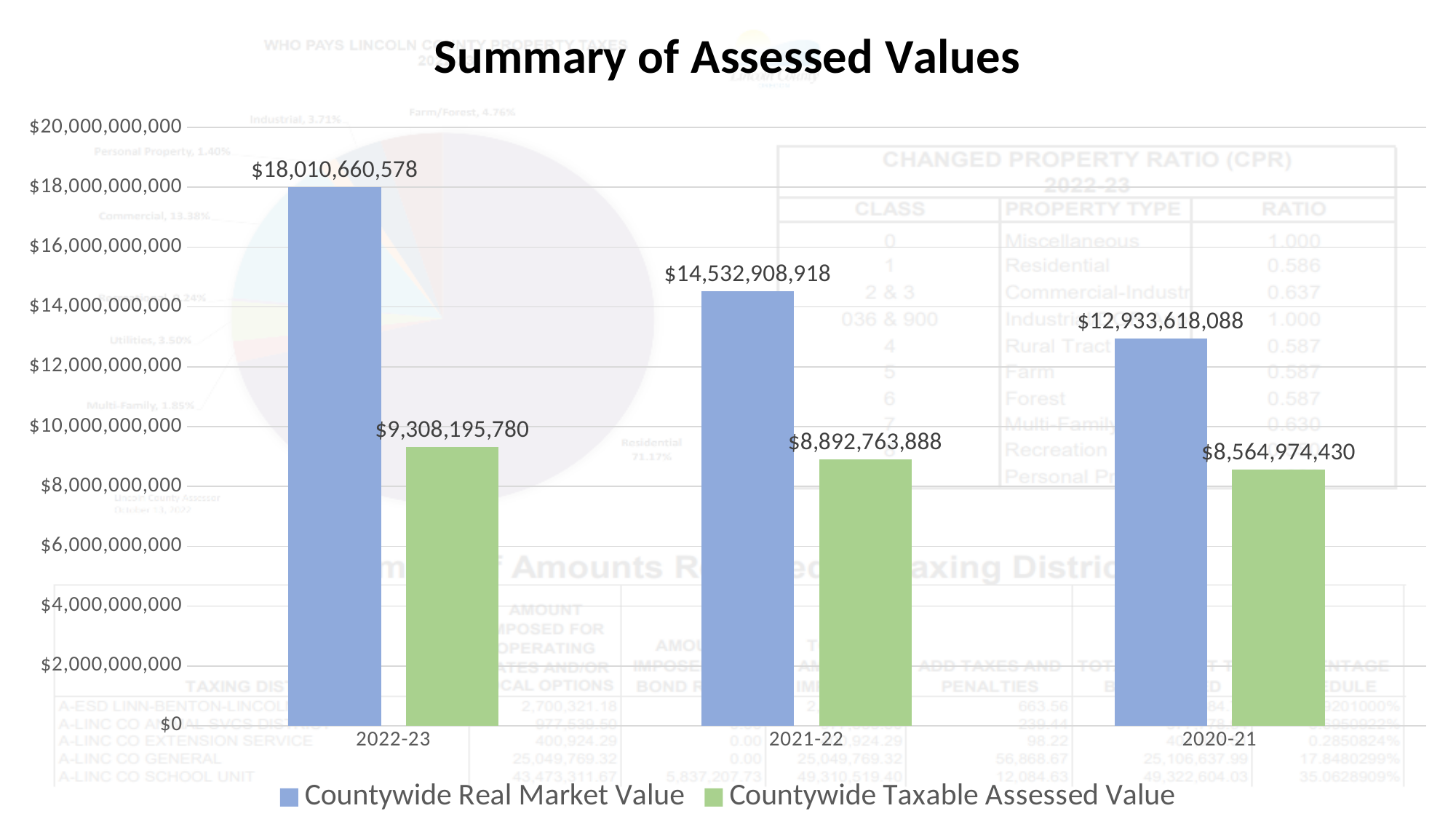
How many years are shown on the x axis? 3 Which is larger: the Countywide Taxable Assessed Value for 2022-23 or the Countywide Real Market Value for 2020-21? Countywide Real Market Value for 2020-21 What type of chart is shown on the slide? Bar chart What is the Countywide Real Market Value for 2020-21? $12,933,618,088 What is the Countywide Taxable Assessed Value for 2020-21? $8,564,974,430 How many series does the legend list? 2 What is the difference between the Countywide Real Market Value and the Countywide Taxable Assessed Value for 2022-23? $8,702,464,798 Which year has the lowest Countywide Taxable Assessed Value? 2020-21 How much higher is the Countywide Real Market Value in 2022-23 than in 2021-22? $3,477,751,660 Which year has the highest Countywide Real Market Value? 2022-23 What is the Countywide Taxable Assessed Value for 2021-22? $8,892,763,888 What is the Countywide Real Market Value for 2022-23? $18,010,660,578